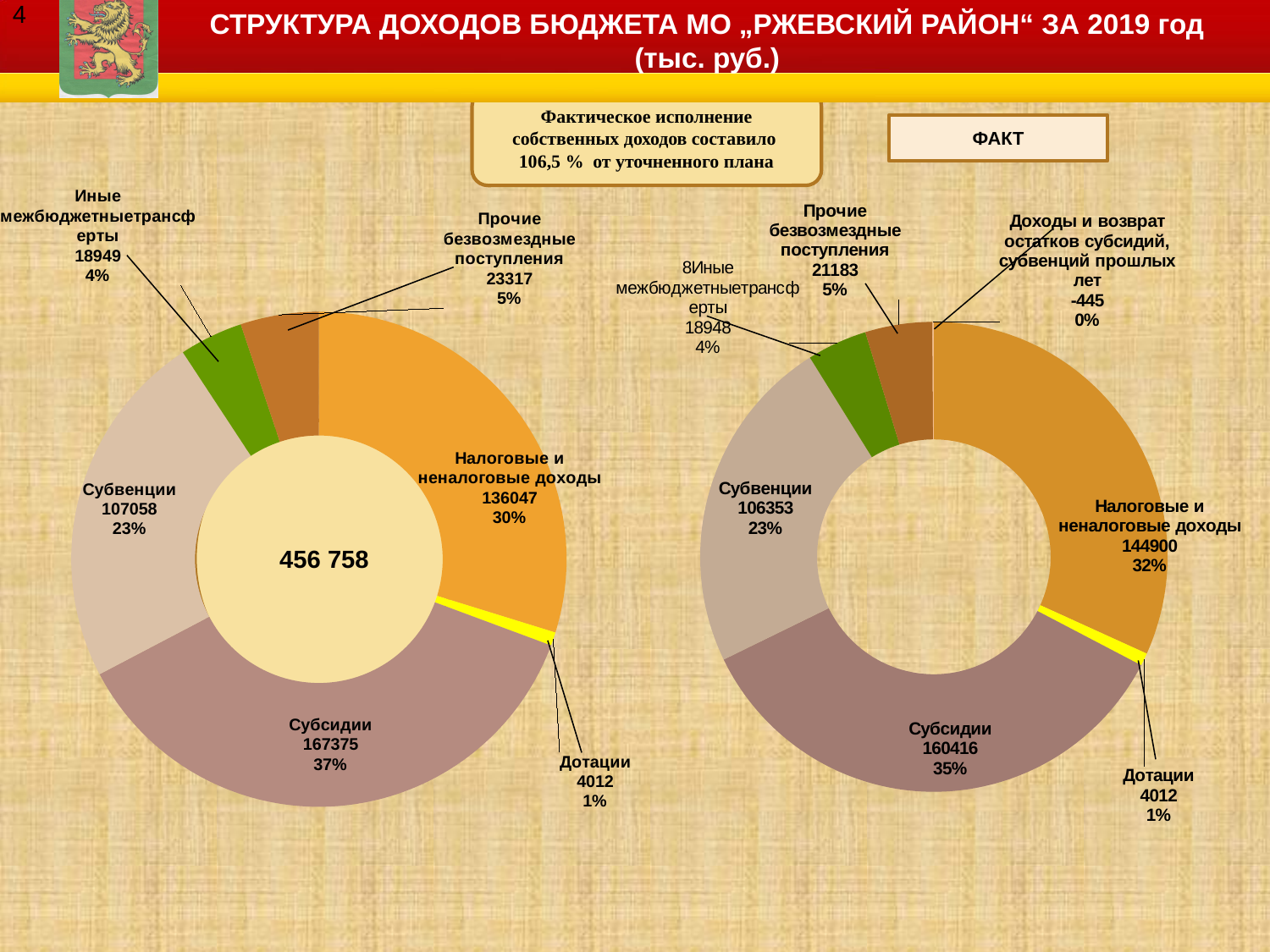
In the left chart, what is the value for Субсидии? 167375 In the right chart (ФАКТ), which category has the smallest value? Доходы и возврат остатков субсидий, субвенций прошлых лет In the left chart, what is the difference between Субсидии and Субвенции? 60317 What total value is shown in the centre of the left chart? 456 758 In the left chart, which category has the largest value? Субсидии In the right chart (ФАКТ), what is the value for Налоговые и неналоговые доходы? 144900 In the right chart (ФАКТ), what share of the total do Субсидии represent? 35% What type of chart is used on this slide? Doughnut chart In the right chart (ФАКТ), which is larger: Субсидии or Налоговые и неналоговые доходы? Субсидии In the left chart, what share of the total do Налоговые и неналоговые доходы represent? 30% How many categories are shown in the left chart? 6 How many categories are shown in the right chart (ФАКТ)? 7